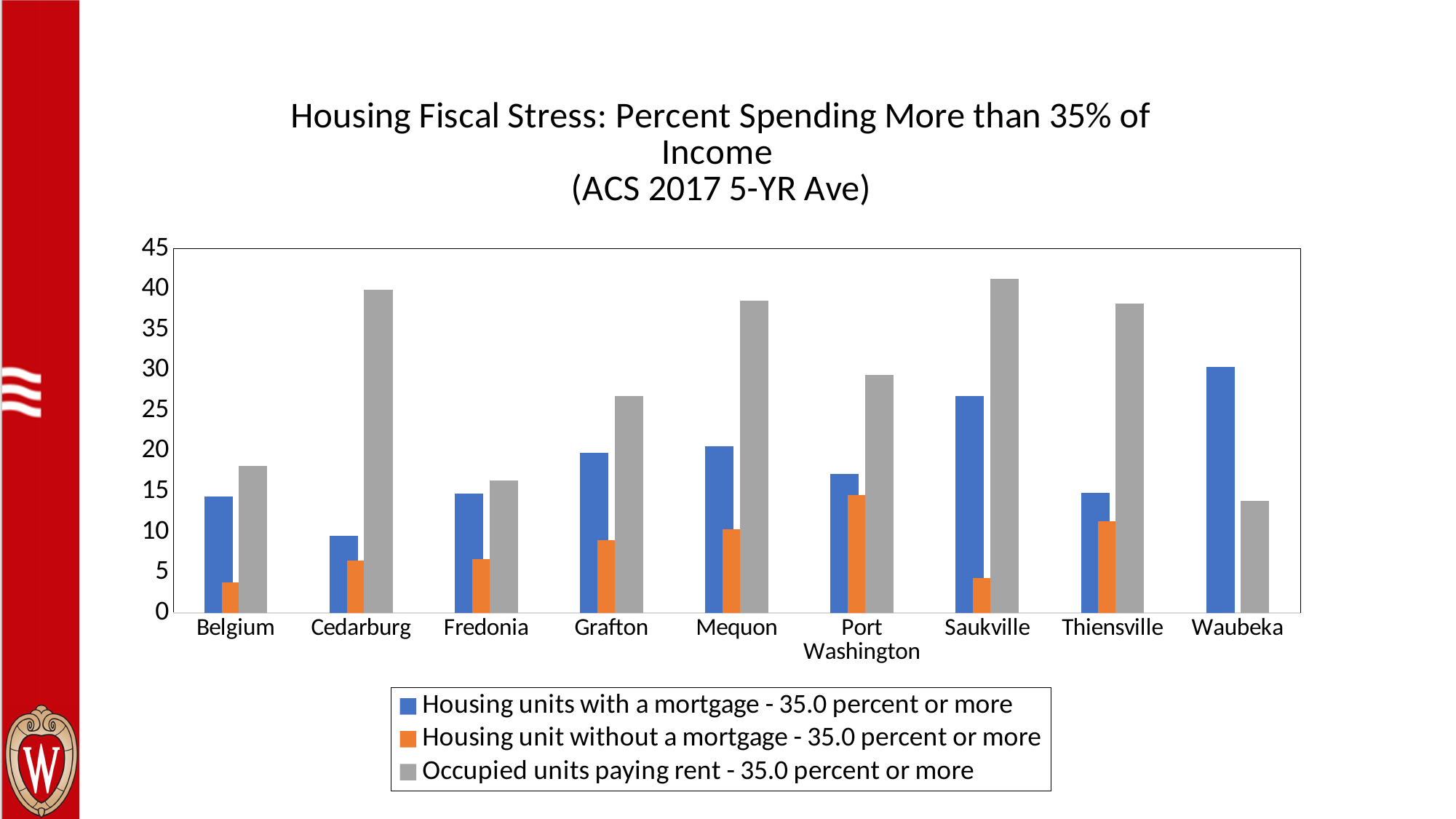
Which community has the highest value for 'Housing unit without a mortgage - 35.0 percent or more'? Port Washington Which community has the lowest value for 'Occupied units paying rent - 35.0 percent or more'? Waubeka Is the value for 'Housing unit without a mortgage - 35.0 percent or more' in Saukville greater or less than 5? less What kind of chart is shown on the slide? Bar chart Which community has the lowest value for 'Housing units with a mortgage - 35.0 percent or more'? Cedarburg How many communities are shown on the x axis of the chart? 9 Is the value for 'Occupied units paying rent - 35.0 percent or more' in Cedarburg greater or less than 35? greater How many series does the chart's legend list? 3 In Waubeka, which is larger: 'Housing units with a mortgage - 35.0 percent or more' or 'Occupied units paying rent - 35.0 percent or more'? Housing units with a mortgage - 35.0 percent or more Which community has the highest value for 'Housing units with a mortgage - 35.0 percent or more'? Waubeka What colour represents 'Occupied units paying rent - 35.0 percent or more' in the chart? Gray Is the value for 'Housing units with a mortgage - 35.0 percent or more' in Belgium greater or less than 15? less